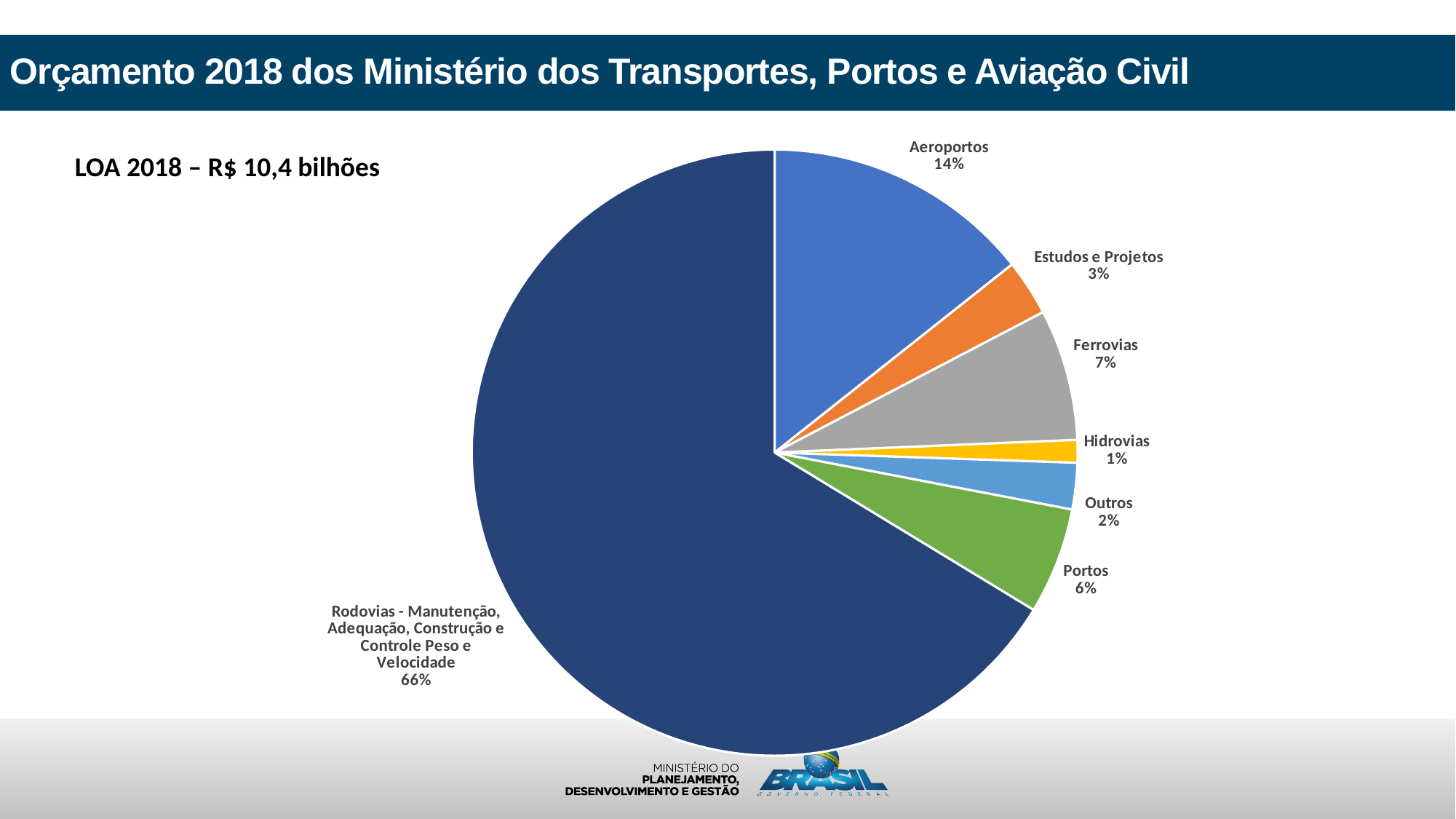
How many slices does the pie chart have? 7 What share of the budget goes to Aeroportos? 14% Which category has the smallest slice of the pie? Hidrovias What is the difference in percentage points between Aeroportos and Ferrovias? 7 Which category has the largest slice of the pie? Rodovias - Manutenção, Adequação, Construção e Controle Peso e Velocidade What share of the budget goes to Ferrovias? 7% What total budget amount is stated on the slide for LOA 2018? R$ 10,4 bilhões What kind of chart is shown on the slide? pie chart What share of the budget goes to Portos? 6% Which is larger, the share for Portos or the share for Outros? Portos